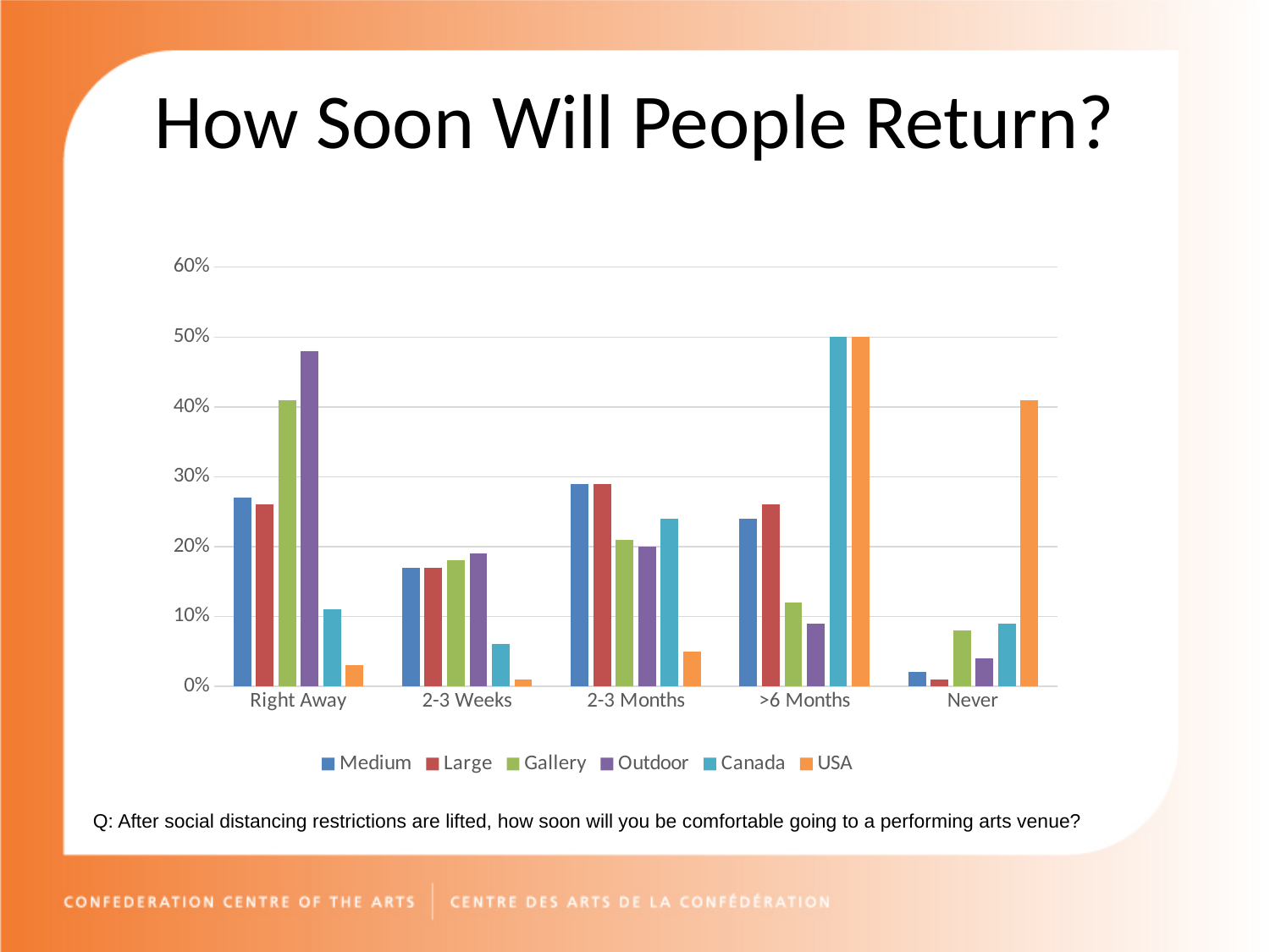
Which is larger in the >6 Months category, Medium or Gallery? Medium Is the value for Outdoor in the Right Away category greater or less than 40%? greater Which series has the highest value in the Never category? USA Does the Canada value rise or fall from 2-3 Months to >6 Months? rise What is the title of the chart? How Soon Will People Return? Which series has the lowest value in the Right Away category? USA Is the value for Canada in the 2-3 Weeks category greater or less than 10%? less How many categories are shown along the x axis? 5 What kind of chart is shown on the slide? bar chart Which series is shown in orange in the legend? USA How many series does the legend list? 6 Which series has the highest value in the Right Away category? Outdoor